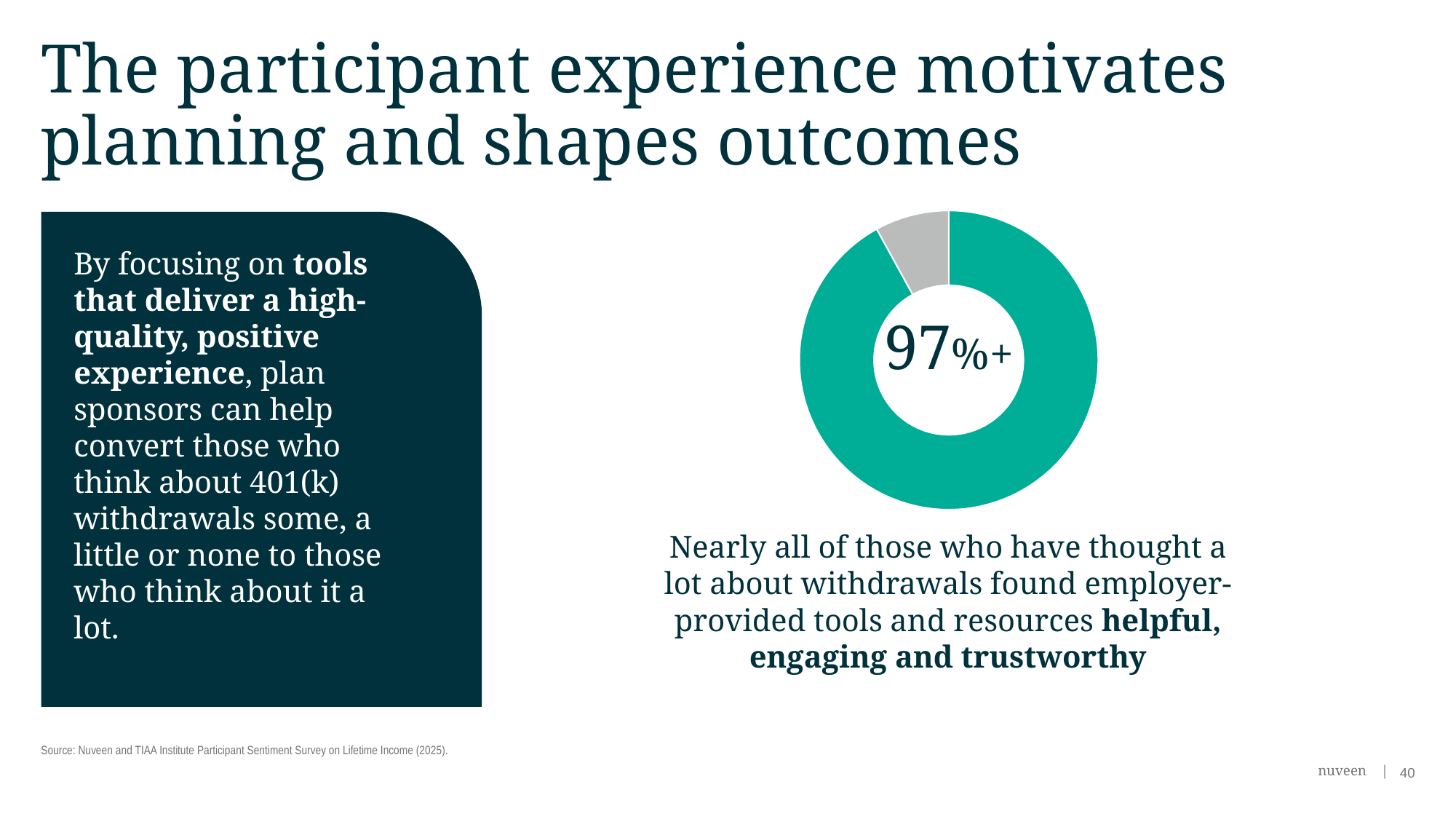
According to the caption under the donut chart, what three qualities did participants attribute to employer-provided tools and resources? helpful, engaging and trustworthy What share of the donut chart does the large teal slice represent, according to the label in the centre? 97%+ What kind of chart is shown on the slide? donut (pie) chart What is the source cited for the chart on the slide? Nuveen and TIAA Institute Participant Sentiment Survey on Lifetime Income (2025) Is the grey slice of the donut chart greater or less than 25% of the whole? less How many slices does the donut chart have? 2 Which colour slice takes up the largest share of the donut chart? teal Which slice of the donut chart is larger, the teal one or the grey one? teal Which colour slice takes up the smallest share of the donut chart? grey Is the teal slice of the donut chart greater or less than 50% of the whole? greater What value is printed in the centre of the donut chart? 97%+